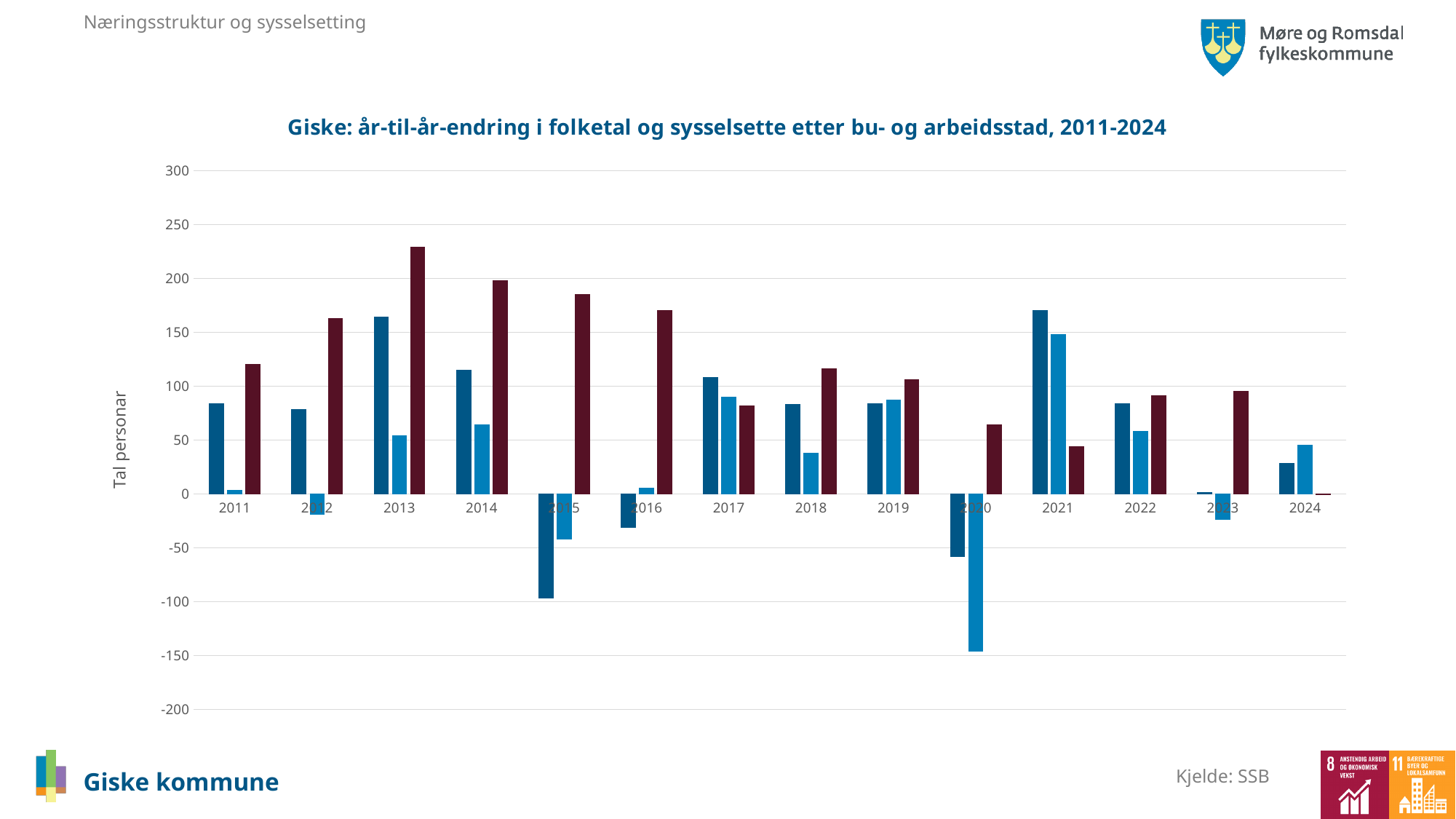
What is the label on the vertical axis of the chart? Tal personar What kind of chart is shown on the slide? bar chart Is the value of the light blue bar for 2020 greater or less than -100? less What is the title of the chart? Giske: år-til-år-endring i folketal og sysselsette etter bu- og arbeidsstad, 2011-2024 How many years are shown along the x axis of the chart? 14 In which year is the dark blue bar the lowest? 2015 Is the value of the dark blue bar for 2021 greater or less than 150? greater In 2021, which bar is taller: the dark blue bar or the light blue bar? dark blue Is the value of the dark red bar for 2013 greater or less than 200? greater Which year has the taller dark red bar: 2014 or 2016? 2014 In which year is the dark red bar the tallest? 2013 In which year is the light blue bar the lowest? 2020